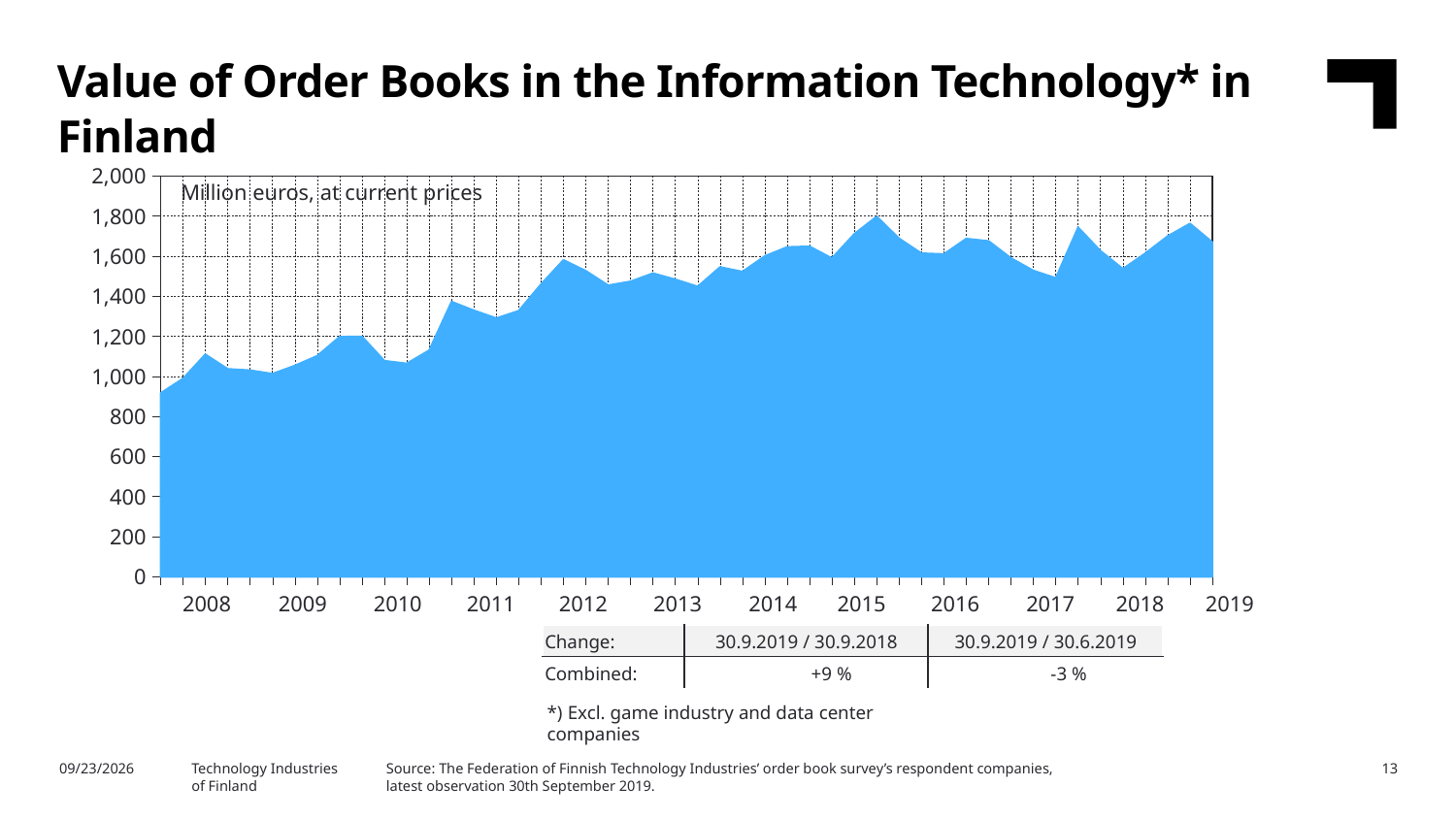
How many year labels are shown on the x axis? 12 Is the value at the beginning of 2012 greater or less than 1,400? greater According to the table below the chart, what is the combined change for 30.9.2019 / 30.9.2018? +9 % Overall, do the values rise or fall from 2008 to 2019? rise What unit is the chart measured in, according to the label inside the plot area? Million euros, at current prices What is the title of the chart on the slide? Value of Order Books in the Information Technology* in Finland What type of chart is shown on the slide? Area chart In which year does the chart show its lowest value? 2008 Is the peak value around 2015 greater or less than 1,600? greater Is the value at the beginning of 2017 greater or less than 1,800? less